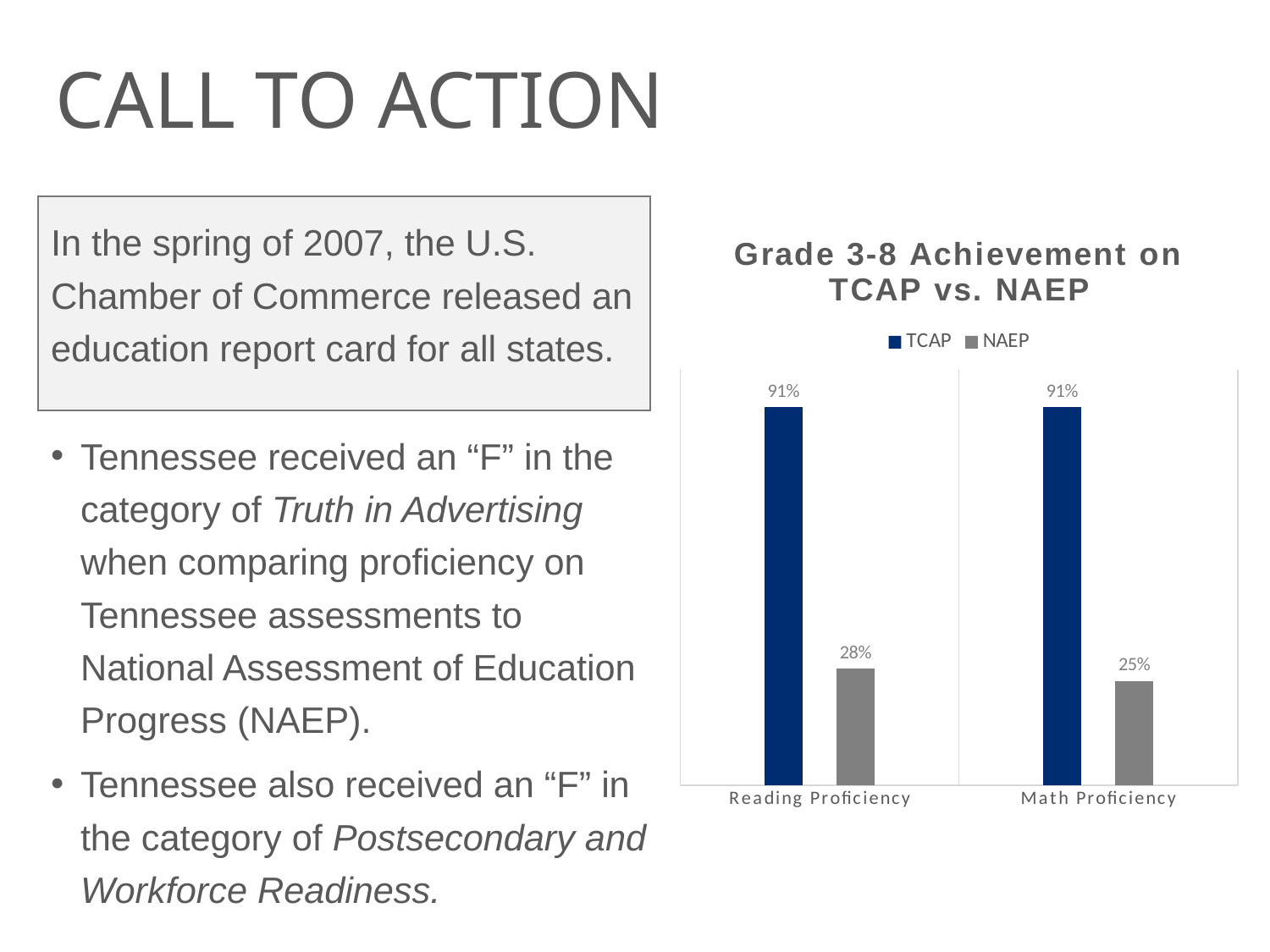
Which category has the lowest NAEP value? Math Proficiency Which series is shown in dark blue? TCAP How many series does the legend list? 2 What is the NAEP value for Math Proficiency? 25% What kind of chart is shown on the slide? Bar chart Which is larger for Math Proficiency, the TCAP value or the NAEP value? TCAP What is the TCAP value for Reading Proficiency? 91% How many categories are shown on the x axis? 2 What is the difference between the TCAP and NAEP values for Math Proficiency? 66% What is the NAEP value for Reading Proficiency? 28% What is the difference between the TCAP and NAEP values for Reading Proficiency? 63% What is the title of the chart? Grade 3-8 Achievement on TCAP vs. NAEP